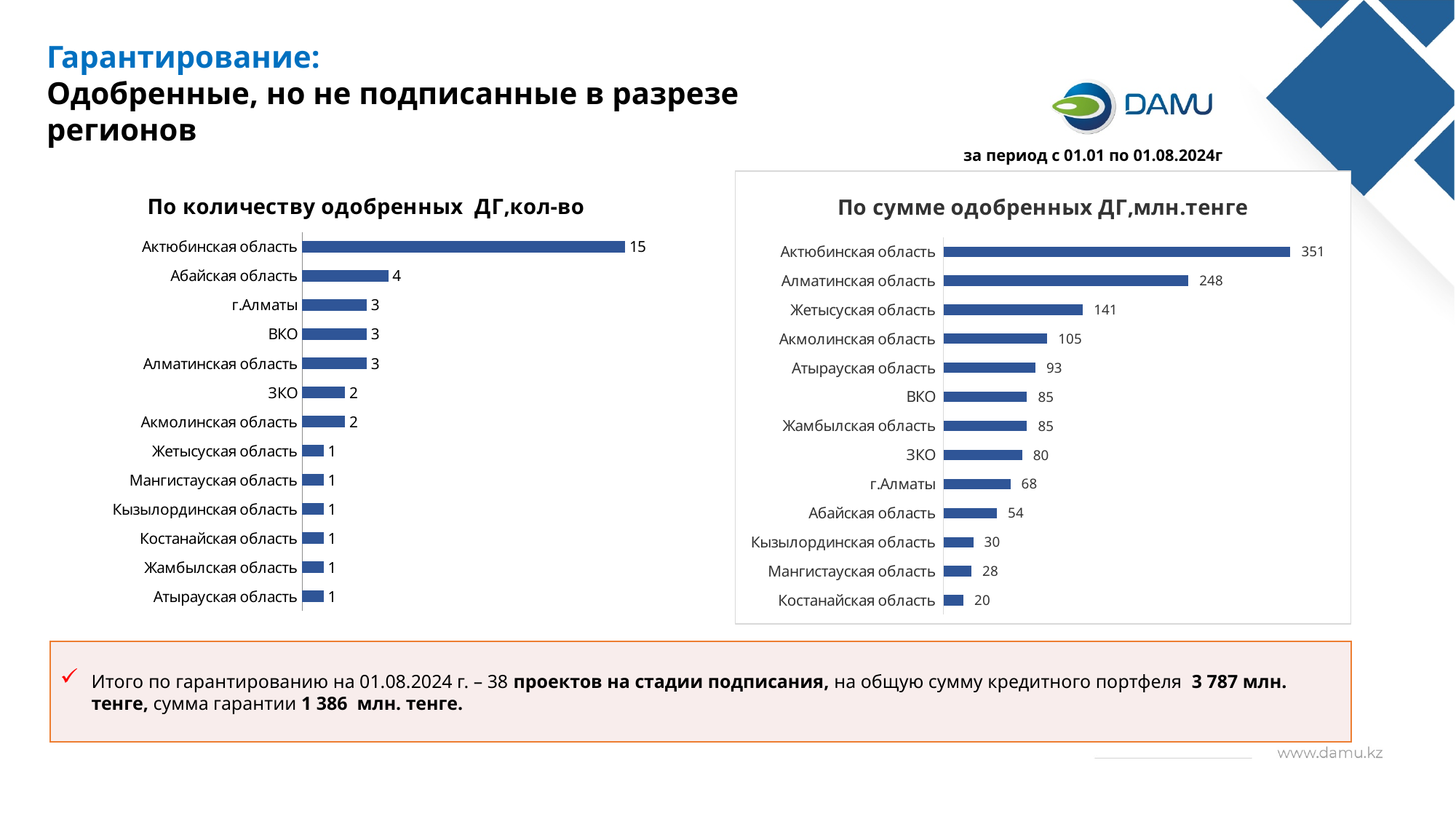
In the chart 'По количеству одобренных ДГ,кол-во', what is the value for Актюбинская область? 15 In the chart 'По сумме одобренных ДГ,млн.тенге', how many regions are listed? 13 In the chart 'По сумме одобренных ДГ,млн.тенге', what is the value for Костанайская область? 20 In the chart 'По количеству одобренных ДГ,кол-во', what is the value for Абайская область? 4 In the chart 'По количеству одобренных ДГ,кол-во', which region has the highest value? Актюбинская область In the chart 'По сумме одобренных ДГ,млн.тенге', what is the difference between Актюбинская область and Алматинская область? 103 In the chart 'По количеству одобренных ДГ,кол-во', how many regions are listed? 13 In the chart 'По сумме одобренных ДГ,млн.тенге', which is larger: Жетысуская область or Акмолинская область? Жетысуская область In the chart 'По количеству одобренных ДГ,кол-во', what is the difference between Актюбинская область and Абайская область? 11 In the chart 'По сумме одобренных ДГ,млн.тенге', which region has the lowest value? Костанайская область In the chart 'По сумме одобренных ДГ,млн.тенге', what is the value for Алматинская область? 248 What type of chart is 'По сумме одобренных ДГ,млн.тенге'? Bar chart